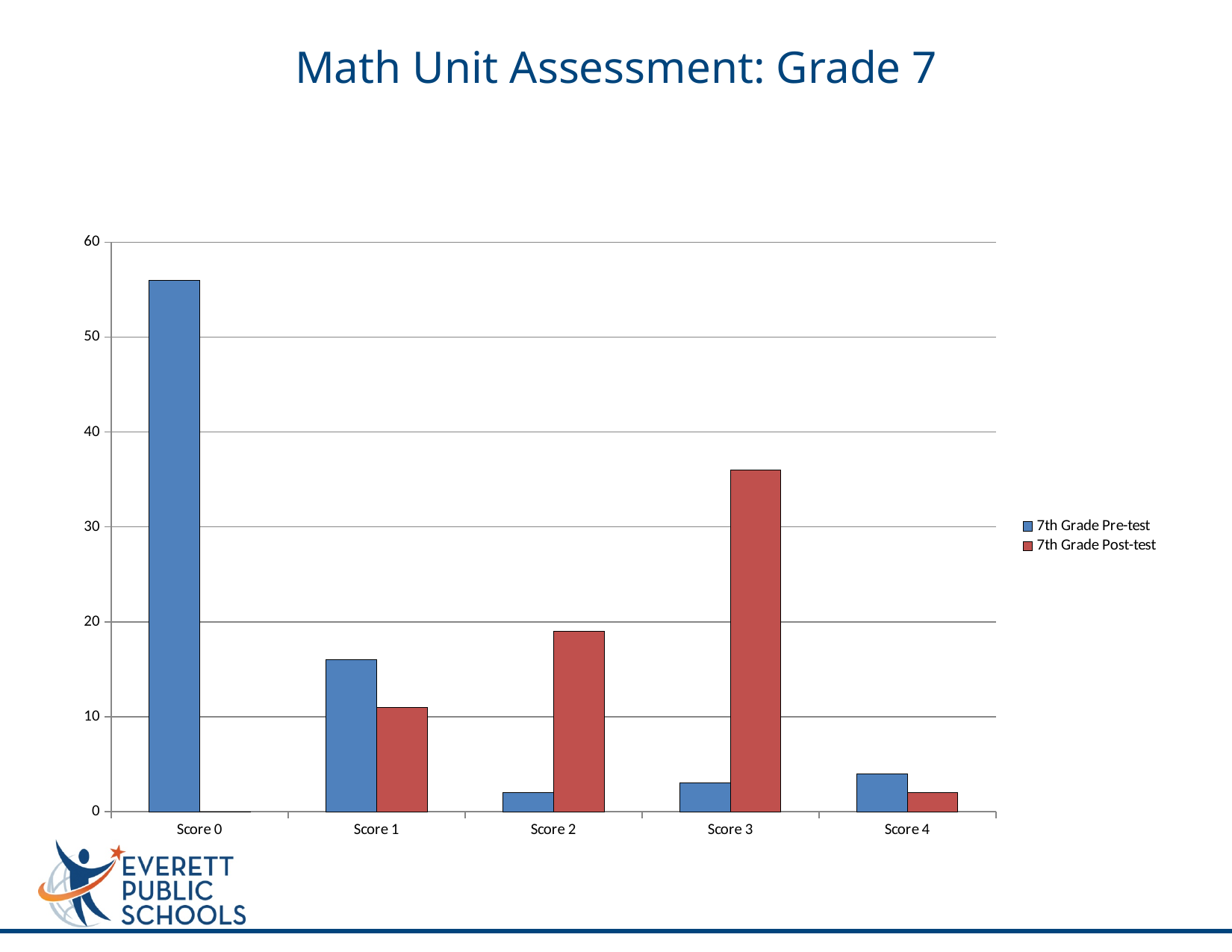
How many series does the legend list? 2 Which score category has the highest 7th Grade Pre-test value? Score 0 How many score categories are shown on the x axis? 5 Which score category has the highest 7th Grade Post-test value? Score 3 Which score category has the lowest 7th Grade Post-test value? Score 0 What kind of chart is shown on the slide? bar chart Is the 7th Grade Pre-test value for Score 0 greater or less than 50? greater For Score 3, which is larger: the 7th Grade Pre-test value or the 7th Grade Post-test value? 7th Grade Post-test Is the 7th Grade Post-test value for Score 3 greater or less than 40? less What is the title of the chart? Math Unit Assessment: Grade 7 Is the 7th Grade Pre-test value for Score 1 greater or less than 10? greater